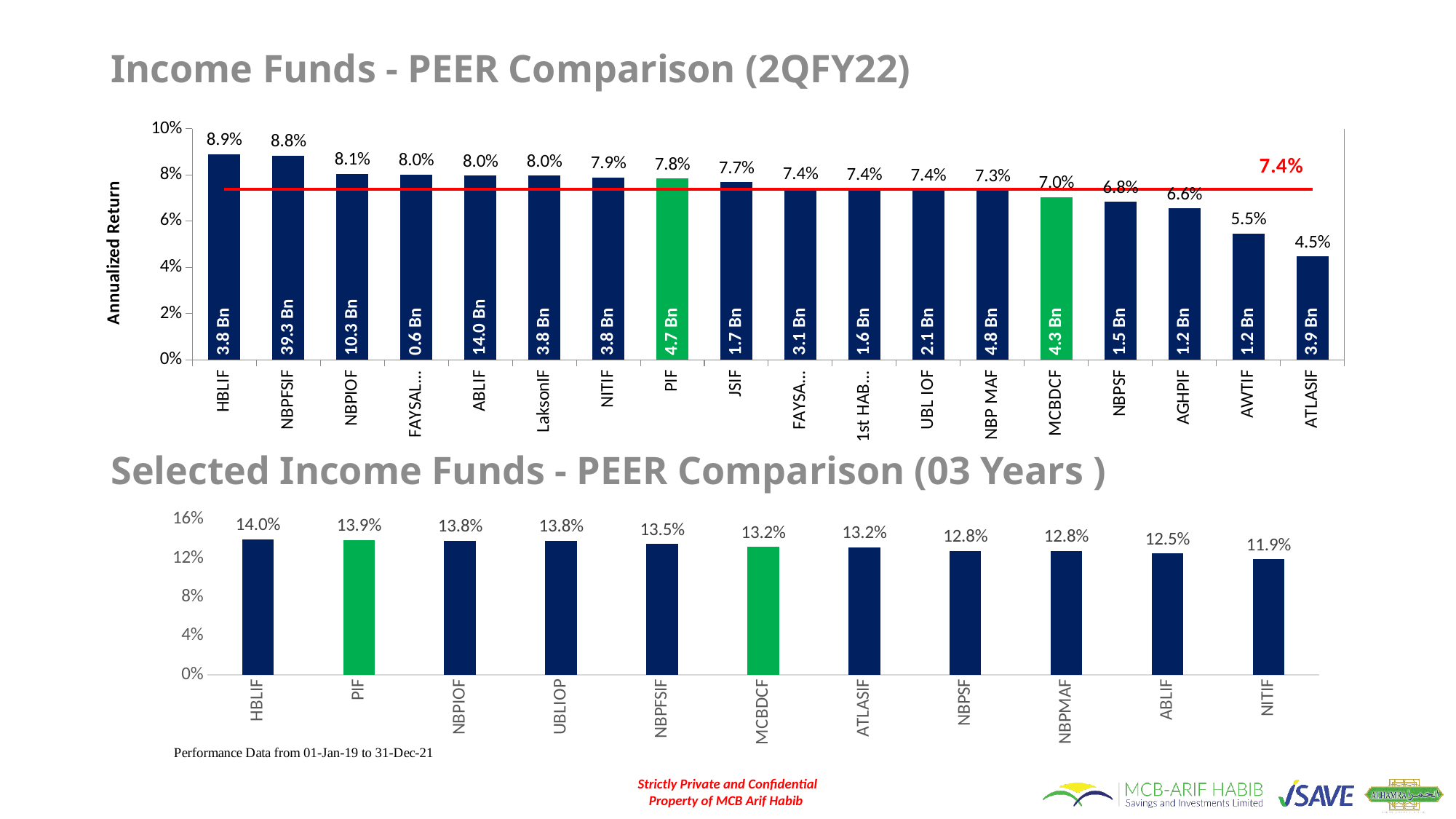
In the 'Income Funds - PEER Comparison (2QFY22)' chart, what fund size is printed on the NBPFSIF bar? 39.3 Bn In the 'Selected Income Funds - PEER Comparison (03 Years )' chart, what is the value for PIF? 13.9% In the 'Income Funds - PEER Comparison (2QFY22)' chart, what value is labelled on the red horizontal line? 7.4% In the 'Selected Income Funds - PEER Comparison (03 Years )' chart, which is larger, the value for MCBDCF or the value for NITIF? MCBDCF In the 'Income Funds - PEER Comparison (2QFY22)' chart, what is the annualized return for MCBDCF? 7.0% In the 'Selected Income Funds - PEER Comparison (03 Years )' chart, how many funds are shown? 11 What type of chart is the 'Selected Income Funds - PEER Comparison (03 Years )' chart? Bar chart In the 'Income Funds - PEER Comparison (2QFY22)' chart, what is the difference between the annualized returns of HBLIF and ATLASIF? 4.4% In the 'Income Funds - PEER Comparison (2QFY22)' chart, how many funds are shown? 18 In the 'Income Funds - PEER Comparison (2QFY22)' chart, which fund has the lowest annualized return? ATLASIF In the 'Selected Income Funds - PEER Comparison (03 Years )' chart, which fund has the highest value? HBLIF In the 'Income Funds - PEER Comparison (2QFY22)' chart, what is the annualized return for HBLIF? 8.9%